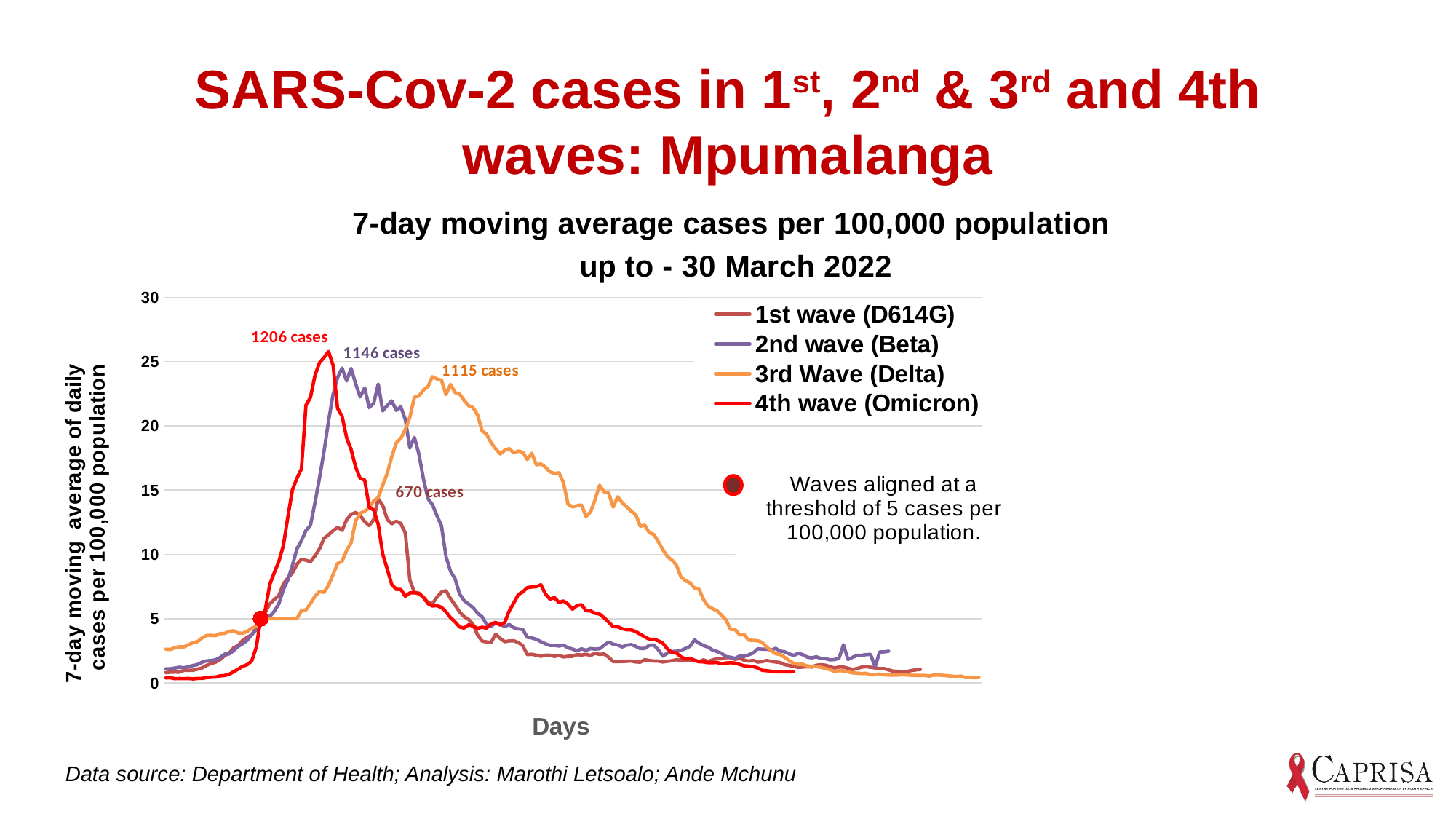
Which wave has the lowest labelled peak case count? 1st wave (D614G) Is the peak of the 1st wave (D614G) line greater or less than 15 cases per 100,000 population? less At what threshold of cases per 100,000 population are the waves aligned? 5 cases per 100,000 population What is the peak case count labelled for the 4th wave (Omicron)? 1206 cases How many series does the legend list? 4 What kind of chart is shown on the slide? Line chart What is the difference between the labelled peak case counts of the 4th wave and the 1st wave? 536 cases What is the peak case count labelled for the 1st wave (D614G)? 670 cases What is the peak case count labelled for the 2nd wave (Beta)? 1146 cases Which wave has the highest labelled peak case count? 4th wave (Omicron) Which has the larger labelled peak case count, the 2nd wave (Beta) or the 3rd Wave (Delta)? 2nd wave (Beta) What is the peak case count labelled for the 3rd Wave (Delta)? 1115 cases